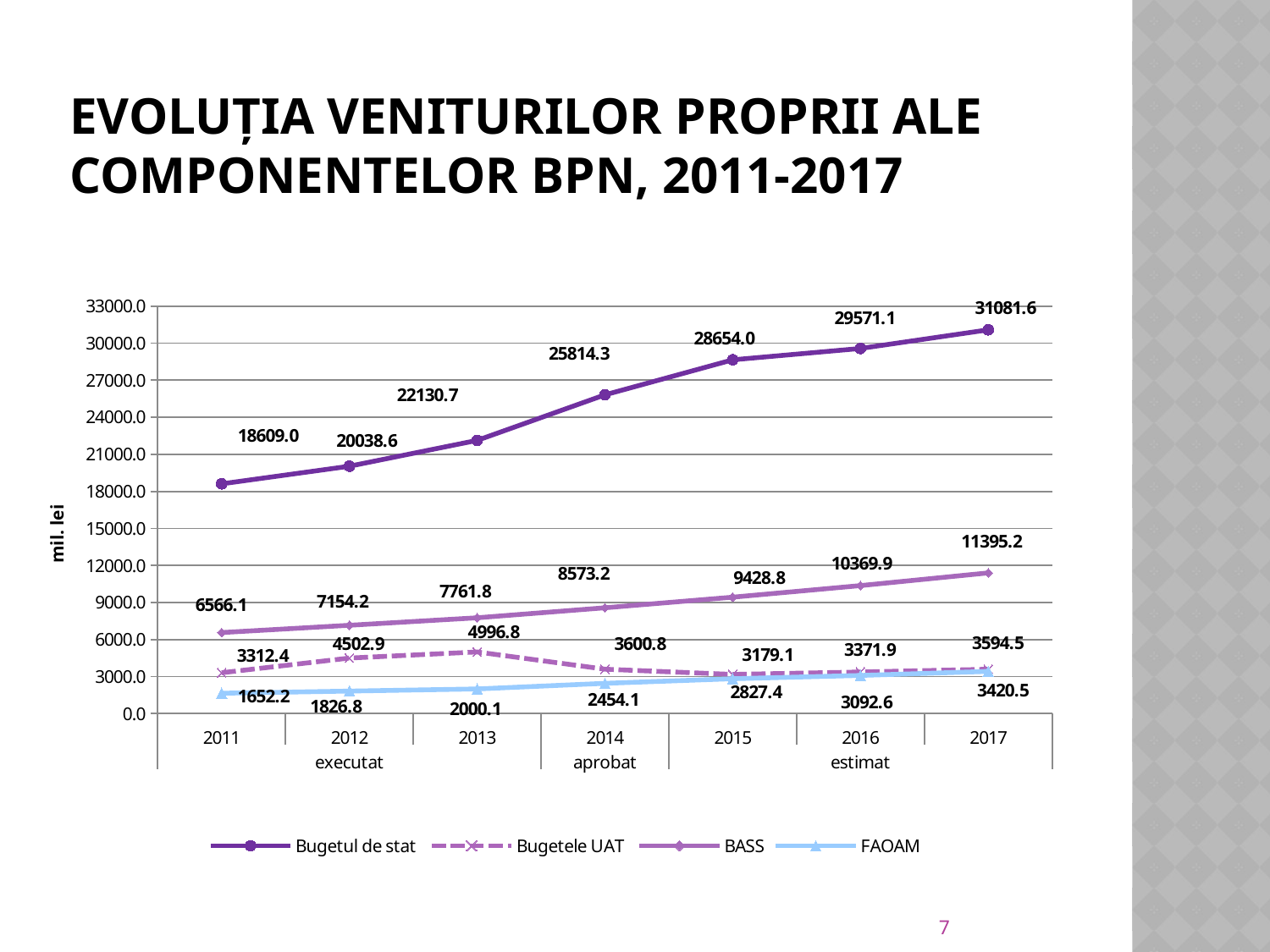
What is the difference between the Bugetul de stat values in 2017 and 2011? 12472.6 How many years are plotted on the x axis? 7 What type of chart is shown on the slide? line chart In which year is the FAOAM value lowest? 2011 What is the value for Bugetele UAT in 2013? 4996.8 What is the value for FAOAM in 2011? 1652.2 What is the value for Bugetul de stat in 2014? 25814.3 Does the BASS series rise or fall from 2011 to 2017? rise Which is larger in 2012: Bugetele UAT or FAOAM? Bugetele UAT What is the value for BASS in 2017? 11395.2 How many series does the legend list? 4 In which year is the Bugetul de stat value highest? 2017